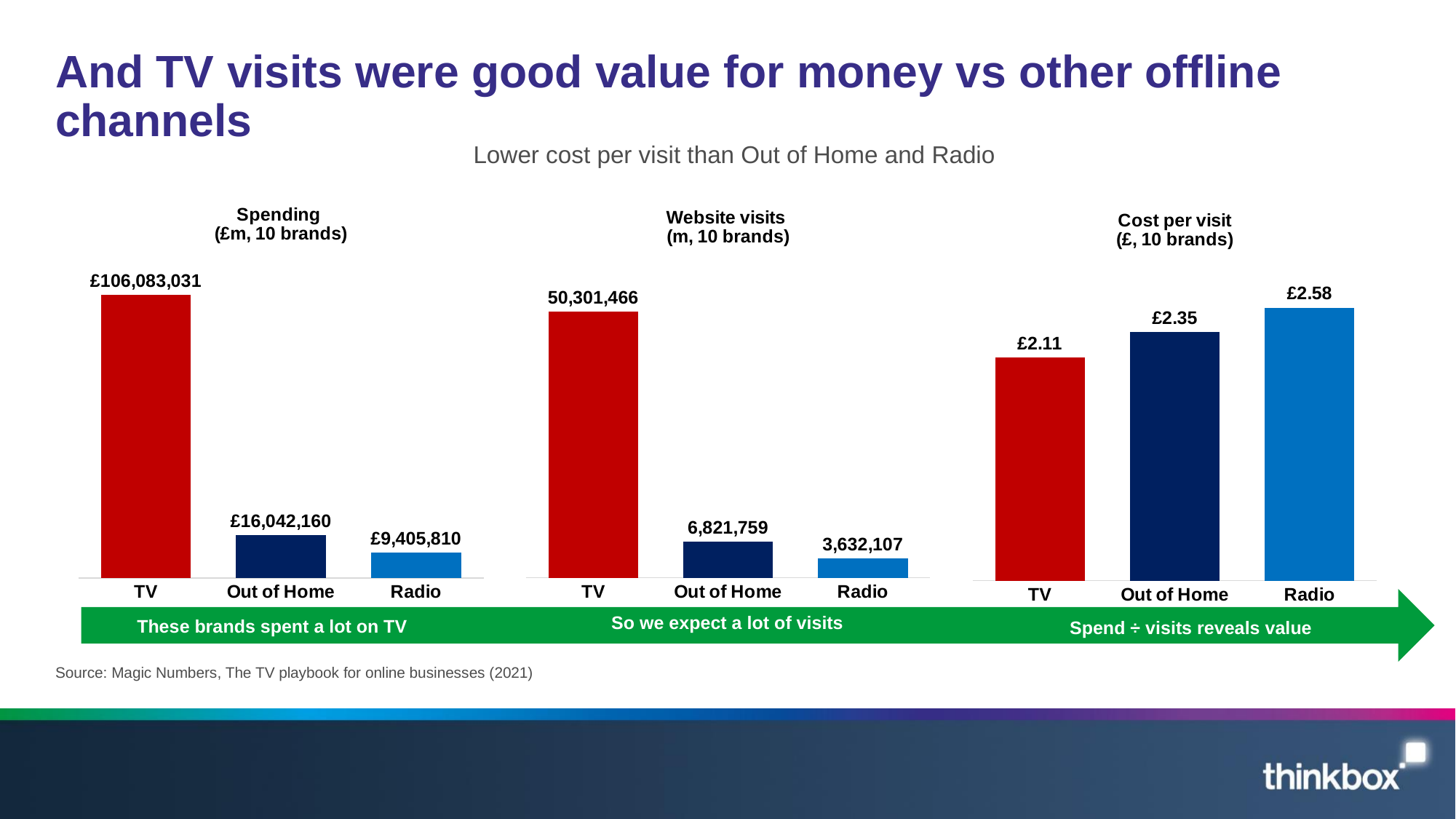
In the Cost per visit chart, which channel has the highest cost per visit? Radio In the Website visits chart, what is the value for Out of Home? 6,821,759 In the Website visits chart, which channel has the lowest value? Radio In the Spending chart, what is the value for TV? £106,083,031 In the Cost per visit chart, which channel has the lowest cost per visit? TV What type of chart is the Cost per visit chart? Bar chart In the Cost per visit chart, what is the value for Out of Home? £2.35 In the Spending chart, what is the value for Radio? £9,405,810 In the Cost per visit chart, what is the difference between Radio and TV? £0.47 In the Spending chart, which is larger, Out of Home or Radio? Out of Home How many categories are shown in the Website visits chart? 3 In the Website visits chart, what is the difference between Out of Home and Radio? 3,189,652